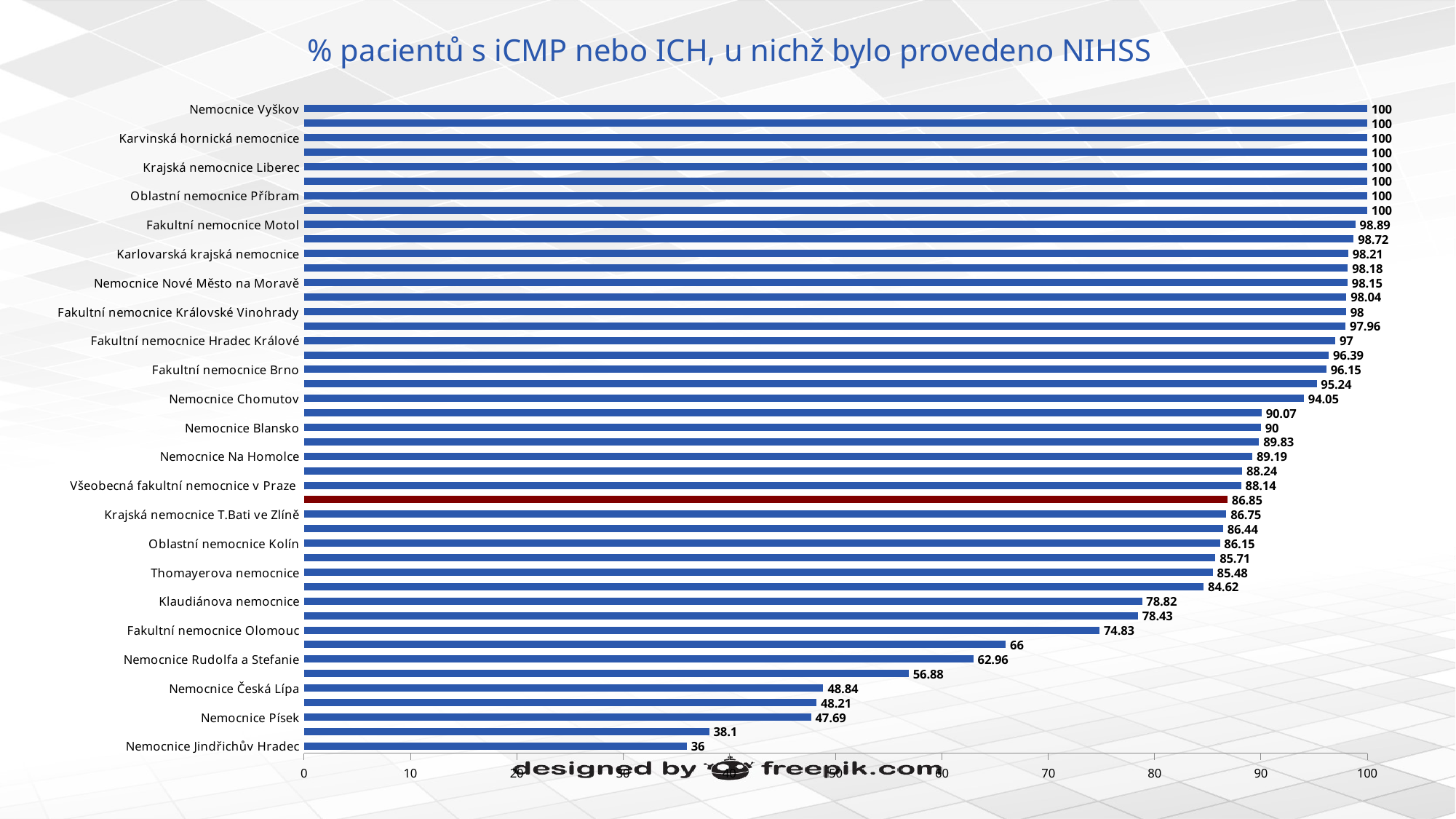
What is the difference between the values for Nemocnice Blansko and Nemocnice Písek? 42.31 What is the highest value shown on the chart? 100 Is the value for Fakultní nemocnice Brno greater or less than 90? greater Which is larger, the value for Thomayerova nemocnice or the value for Klaudiánova nemocnice? Thomayerova nemocnice What is the value for Fakultní nemocnice Motol? 98.89 Which labelled hospital has the lowest value? Nemocnice Jindřichův Hradec What is the value for Nemocnice Jindřichův Hradec? 36 What is the value of the bar highlighted in red? 86.85 What is the value for Nemocnice Chomutov? 94.05 What is the value for Fakultní nemocnice Olomouc? 74.83 Is the value for Nemocnice Rudolfa a Stefanie greater or less than 70? less What kind of chart is shown on the slide? bar chart